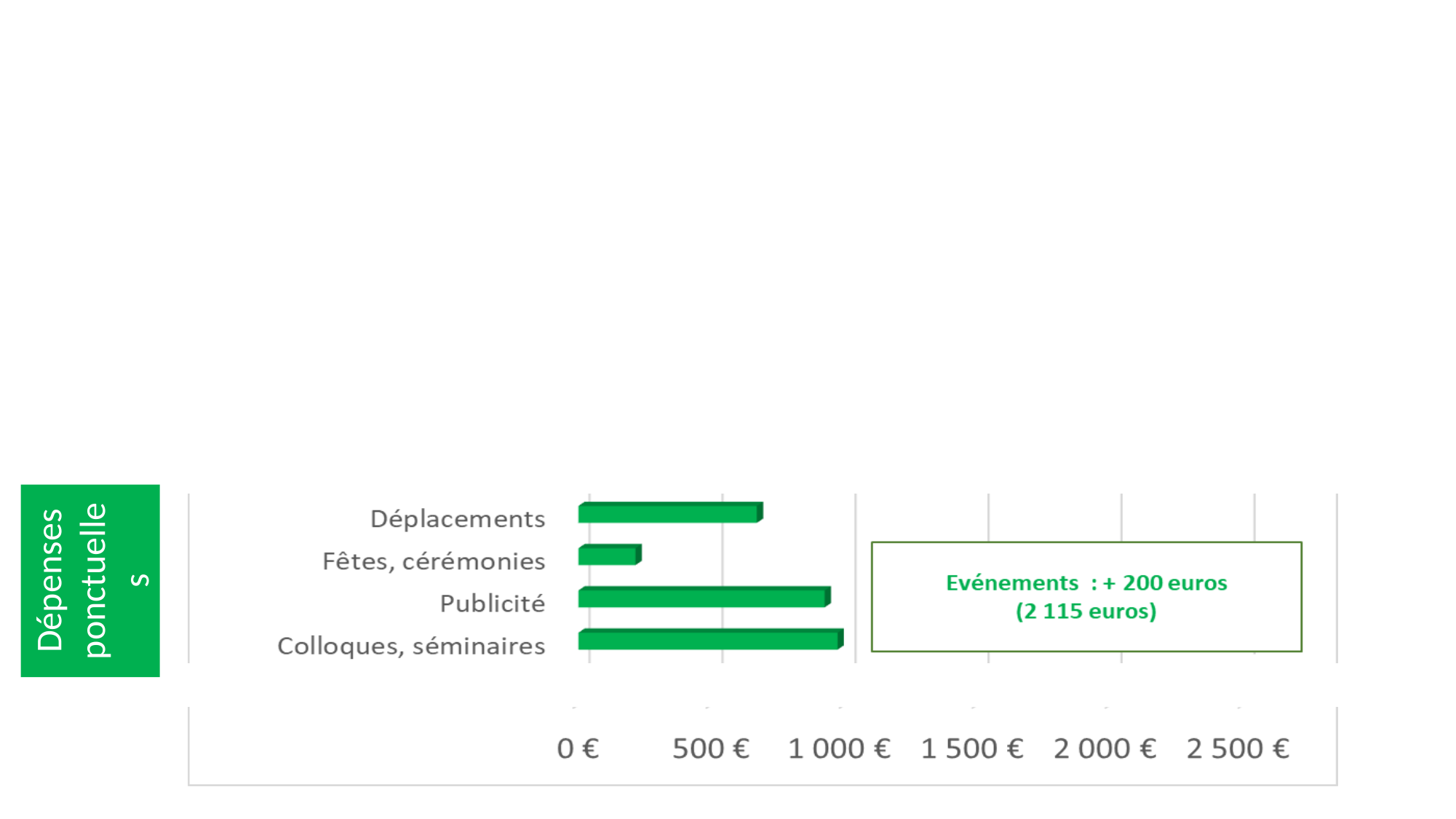
Is the value for Fêtes, cérémonies greater or less than 500 €? less How many categories are plotted in the chart? 4 Is the value for Déplacements greater or less than 1 000 €? less Which is larger, the value for Déplacements or the value for Fêtes, cérémonies? Déplacements What text appears in the green label to the left of the chart? Dépenses ponctuelles Is the value for Colloques, séminaires greater or less than 500 €? greater What kind of chart is shown on the slide? bar chart Which is larger, the value for Publicité or the value for Déplacements? Publicité Which category has the lowest value in the chart? Fêtes, cérémonies What is the highest tick label shown on the horizontal axis of the chart? 2 500 €